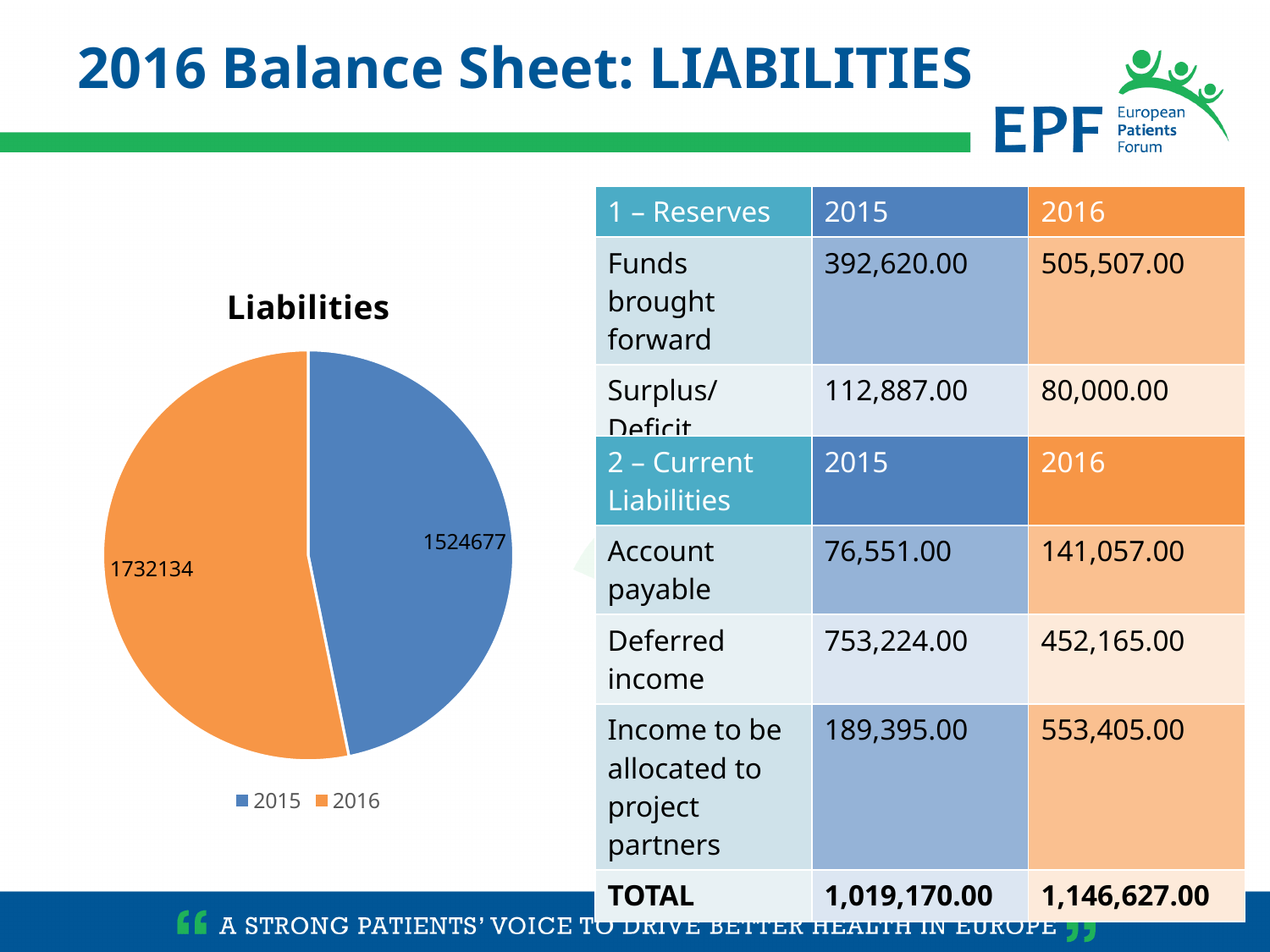
What is the value of the 2016 slice in the Liabilities pie chart? 1732134 How many slices does the Liabilities pie chart have? 2 What is the combined total of the two slices in the Liabilities pie chart? 3256811 How many entries does the legend of the Liabilities pie chart list? 2 What is the value of the 2015 slice in the Liabilities pie chart? 1524677 What is the title of the chart? Liabilities Which year has the larger slice in the Liabilities pie chart? 2016 Which year has the smaller slice in the Liabilities pie chart? 2015 What colour is the 2016 slice in the Liabilities pie chart? orange What kind of chart is shown on the slide? pie chart What is the difference between the 2016 and 2015 values in the Liabilities pie chart? 207457 Is the 2016 slice larger or smaller than the 2015 slice in the Liabilities pie chart? larger